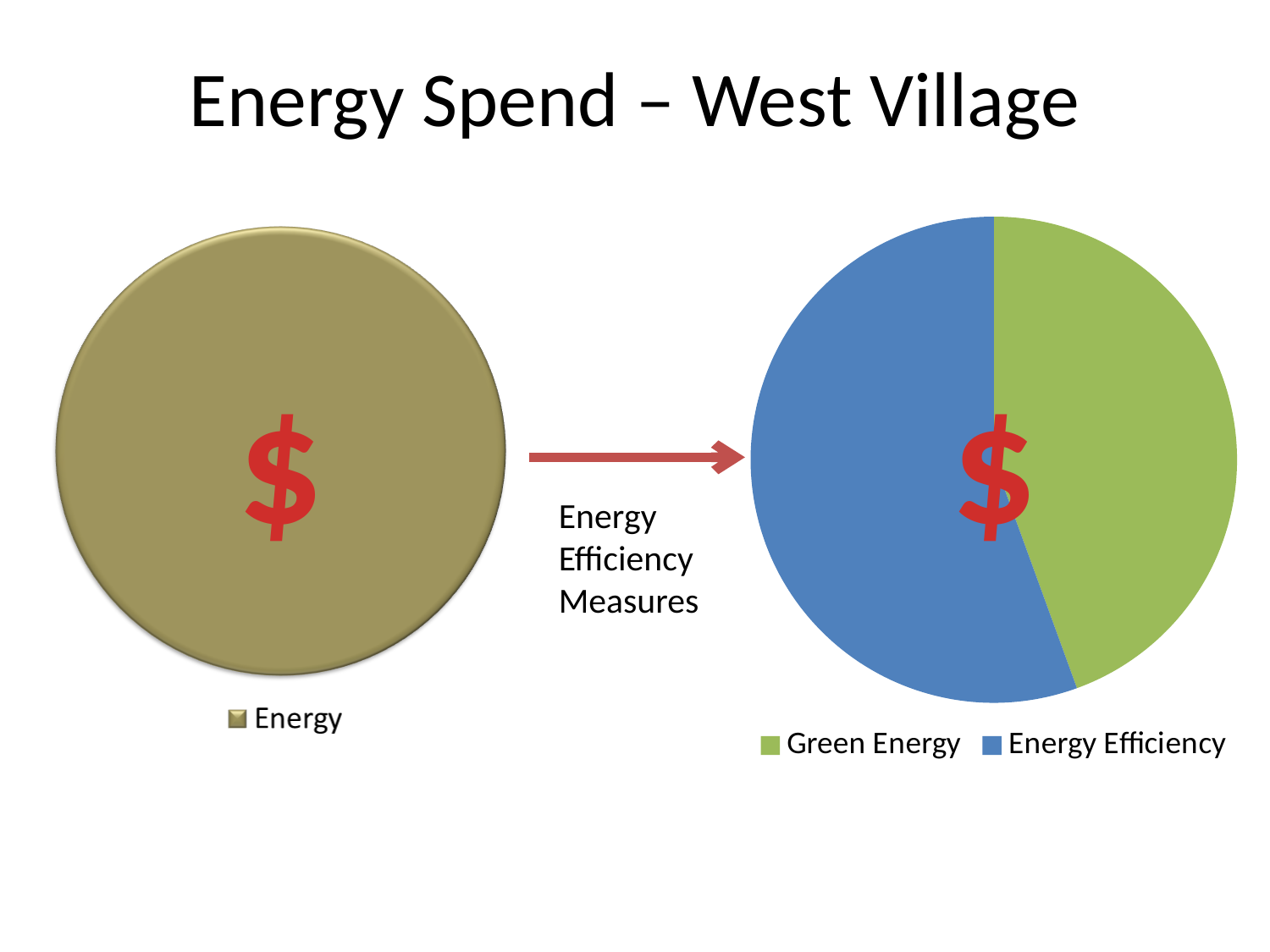
What kind of chart is the chart on the left of the slide? pie chart What is the title of the slide containing the two pie charts? Energy Spend – West Village In the pie chart on the right of the slide, which category has the largest slice? Energy Efficiency How many entries does the legend of the pie chart on the right of the slide list? 2 In the pie chart on the right of the slide, which category has the smallest slice? Green Energy What is the label of the only slice in the pie chart on the left of the slide? Energy How many entries does the legend of the pie chart on the left of the slide list? 1 What kind of chart is the chart on the right of the slide? pie chart How many slices does the pie chart on the right of the slide have? 2 In the pie chart on the right of the slide, what colour is the Green Energy slice? green How many slices does the pie chart on the left of the slide have? 1 In the pie chart on the right of the slide, which slice is larger, Green Energy or Energy Efficiency? Energy Efficiency